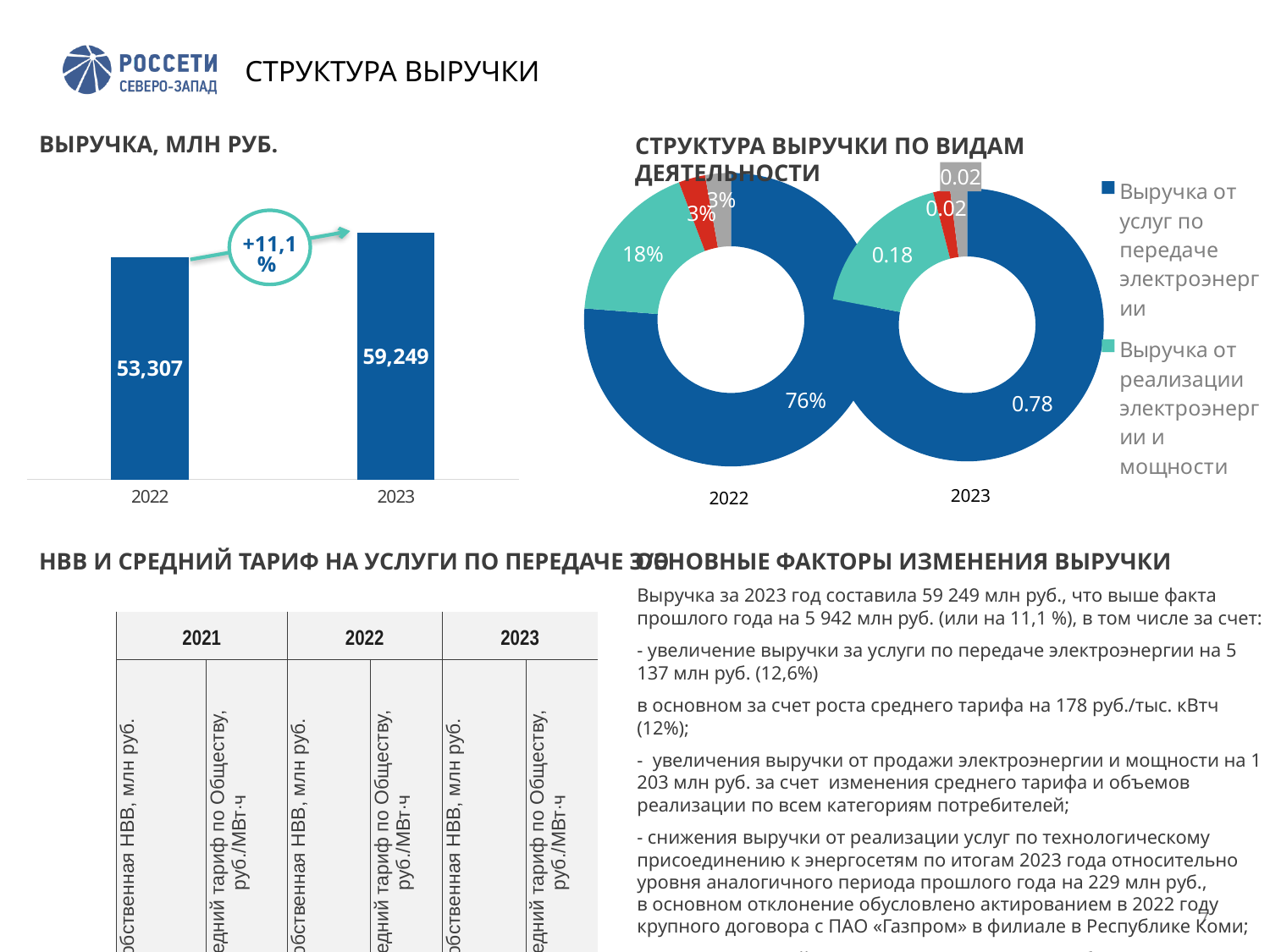
In the chart 'СТРУКТУРА ВЫРУЧКИ ПО ВИДАМ ДЕЯТЕЛЬНОСТИ', what share does 'Выручка от услуг по передаче электроэнергии' have in the 2022 donut? 76% In the chart 'ВЫРУЧКА, МЛН РУБ.', what is the difference between the 2023 and 2022 values? 5,942 What kind of chart is 'ВЫРУЧКА, МЛН РУБ.'? Bar chart In the chart 'ВЫРУЧКА, МЛН РУБ.', what is the value for 2023? 59,249 In the chart 'ВЫРУЧКА, МЛН РУБ.', what percentage change is shown in the circle between the two bars? +11,1 % In the chart 'СТРУКТУРА ВЫРУЧКИ ПО ВИДАМ ДЕЯТЕЛЬНОСТИ', which category has the largest share in the 2022 donut? Выручка от услуг по передаче электроэнергии In the chart 'ВЫРУЧКА, МЛН РУБ.', what is the value for 2022? 53,307 In the chart 'ВЫРУЧКА, МЛН РУБ.', which year has the larger value, 2022 or 2023? 2023 In the chart 'СТРУКТУРА ВЫРУЧКИ ПО ВИДАМ ДЕЯТЕЛЬНОСТИ', what share does 'Выручка от реализации электроэнергии и мощности' have in the 2022 donut? 18% How many years are shown in the chart 'ВЫРУЧКА, МЛН РУБ.'? 2 In the chart 'ВЫРУЧКА, МЛН РУБ.', do the values rise or fall from 2022 to 2023? Rise In the chart 'СТРУКТУРА ВЫРУЧКИ ПО ВИДАМ ДЕЯТЕЛЬНОСТИ', what value is shown for 'Выручка от услуг по передаче электроэнергии' in the 2023 donut? 0.78